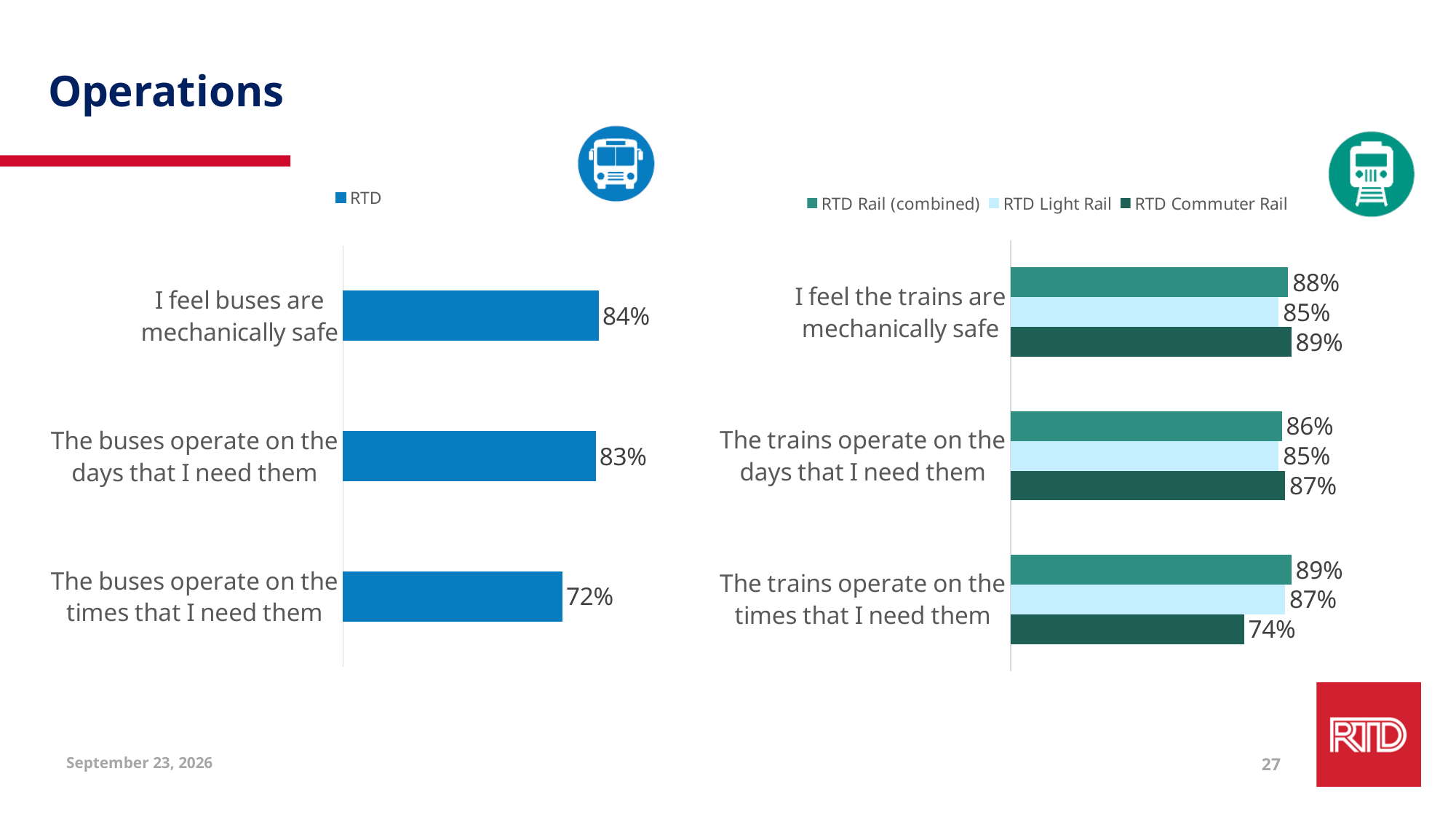
In the left (bus) chart, which category has the lowest value? The buses operate on the times that I need them In the right (rail) chart, what is the RTD Commuter Rail value for 'I feel the trains are mechanically safe'? 89% In the left (bus) chart, what is the value for 'The buses operate on the times that I need them'? 72% In the right (rail) chart, what is the difference between the RTD Light Rail and RTD Commuter Rail values for 'The trains operate on the times that I need them'? 13% In the right (rail) chart, how many series does the legend list? 3 In the right (rail) chart, what is the RTD Rail (combined) value for 'The trains operate on the days that I need them'? 86% In the left (bus) chart, what is the value for 'I feel buses are mechanically safe'? 84% What kind of chart is the left (bus) chart? Bar chart In the right (rail) chart, which series has the lowest value for 'The trains operate on the times that I need them'? RTD Commuter Rail In the left (bus) chart, what is the difference between 'I feel buses are mechanically safe' and 'The buses operate on the times that I need them'? 12% In the right (rail) chart, what is the RTD Light Rail value for 'The trains operate on the times that I need them'? 87% In the right (rail) chart, for 'The trains operate on the times that I need them', which is larger: RTD Light Rail or RTD Commuter Rail? RTD Light Rail